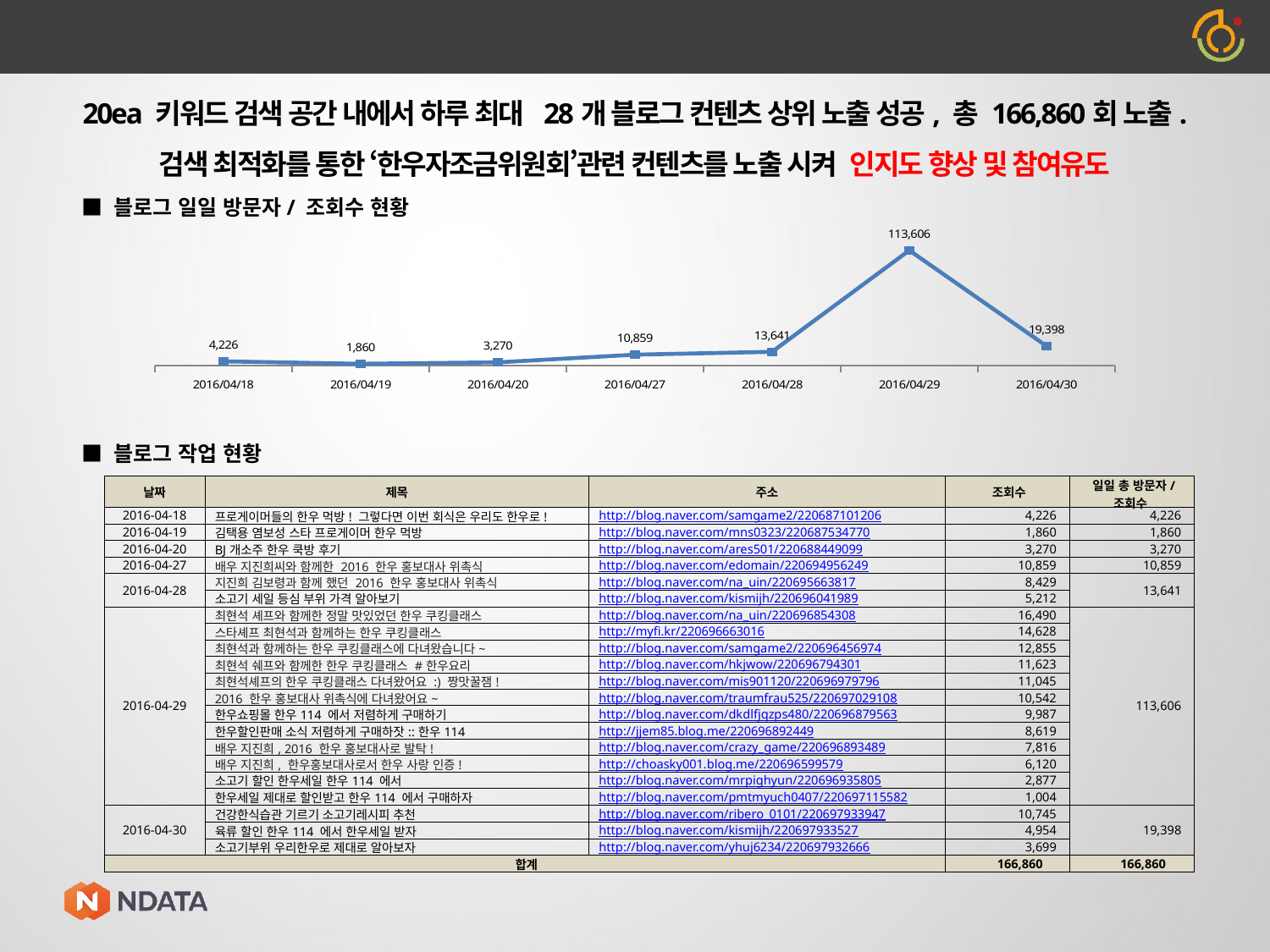
What is the value plotted for 2016/04/30? 19,398 Does the line rise or fall from 2016/04/29 to 2016/04/30? fall What is the value plotted for 2016/04/18? 4,226 How many dates are plotted on the line chart? 7 What type of chart is shown under the heading '블로그 일일 방문자 / 조회수 현황'? line chart Which date has the highest value on the line chart? 2016/04/29 What is the difference between the values for 2016/04/29 and 2016/04/30? 94,208 Which date has the lowest value on the line chart? 2016/04/19 What is the value plotted for 2016/04/27? 10,859 Which is larger, the value for 2016/04/20 or the value for 2016/04/19? 2016/04/20 What is the value plotted for 2016/04/29? 113,606 What is the difference between the values for 2016/04/28 and 2016/04/27? 2,782